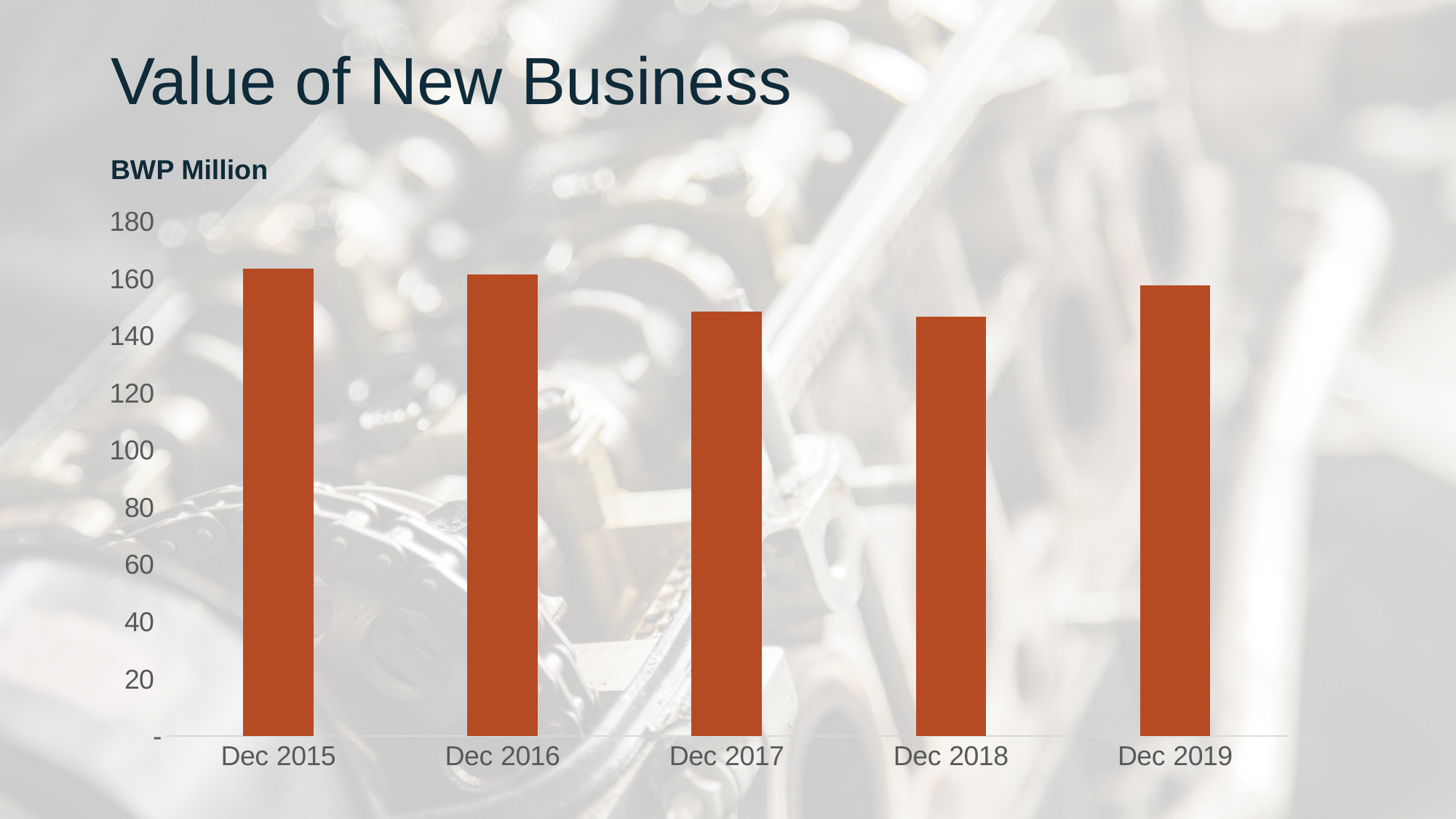
Is the value for Dec 2017 greater or less than 160? less Which is larger, the value for Dec 2019 or the value for Dec 2018? Dec 2019 Is the value for Dec 2015 greater or less than 140? greater How many categories (time points) are shown on the x axis? 5 Is the value for Dec 2016 greater or less than 140? greater Which is larger, the value for Dec 2015 or the value for Dec 2017? Dec 2015 What kind of chart is shown on the slide? bar chart Do the values rise or fall from Dec 2015 to Dec 2018? fall What unit is shown above the chart's vertical axis? BWP Million What is the title of the chart? Value of New Business